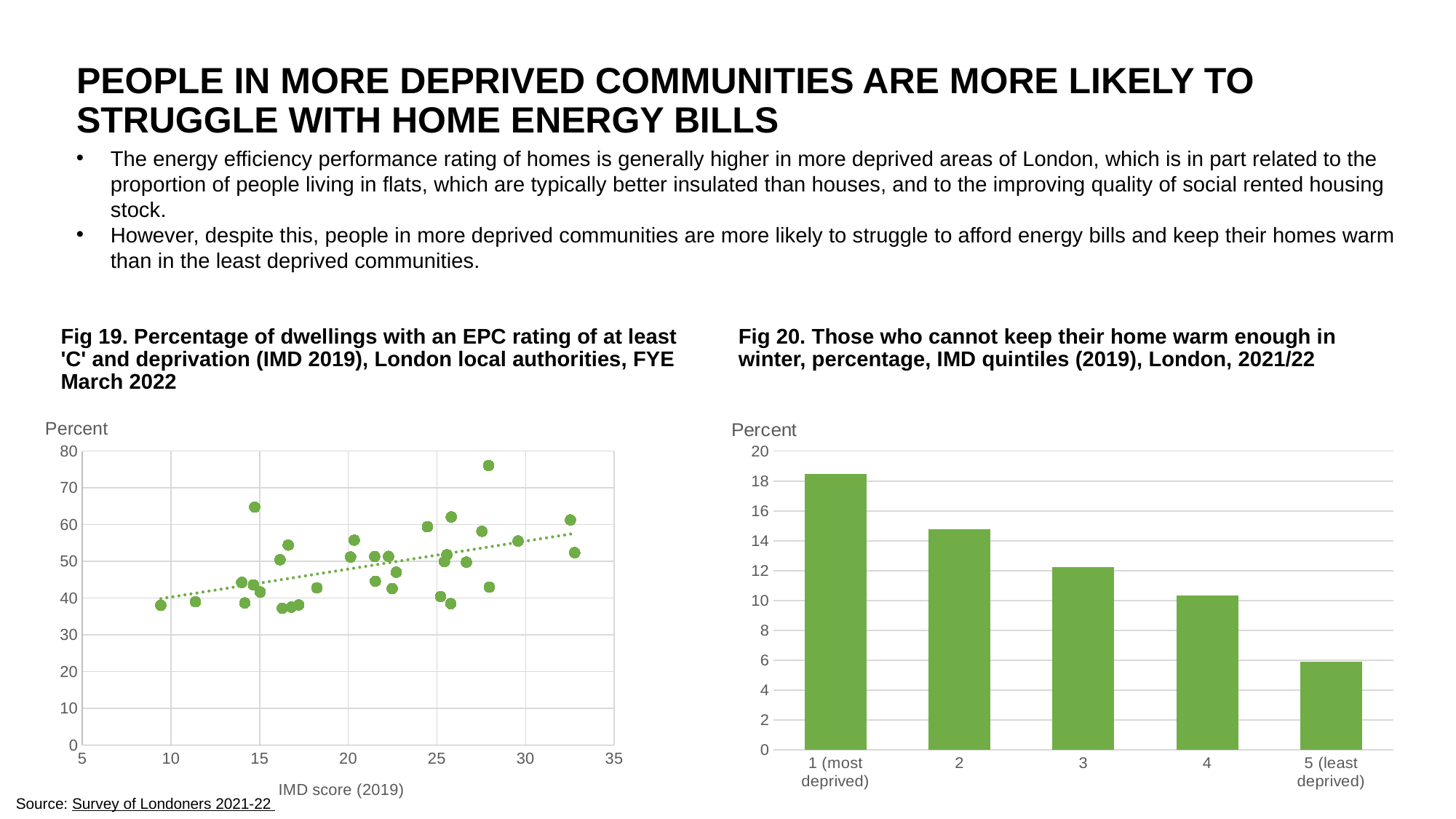
What kind of chart is Fig 19? scatter plot In Fig 20, which IMD quintile has the highest percentage of people who cannot keep their home warm enough in winter? 1 (most deprived) In Fig 20, how many IMD quintiles are shown on the x axis? 5 In Fig 20, is the value for quintile 2 greater or less than 16? less In Fig 20, is the value for quintile 3 greater or less than 10? greater In Fig 20, do the values rise or fall as you move from quintile 1 (most deprived) to quintile 5 (least deprived)? fall What kind of chart is Fig 20? bar chart In Fig 20, is the value for quintile 1 (most deprived) greater or less than 16? greater In Fig 20, which IMD quintile has the lowest percentage? 5 (least deprived) In Fig 19, what is the label of the x axis? IMD score (2019) In Fig 20, is the value for quintile 2 larger or smaller than the value for quintile 4? larger